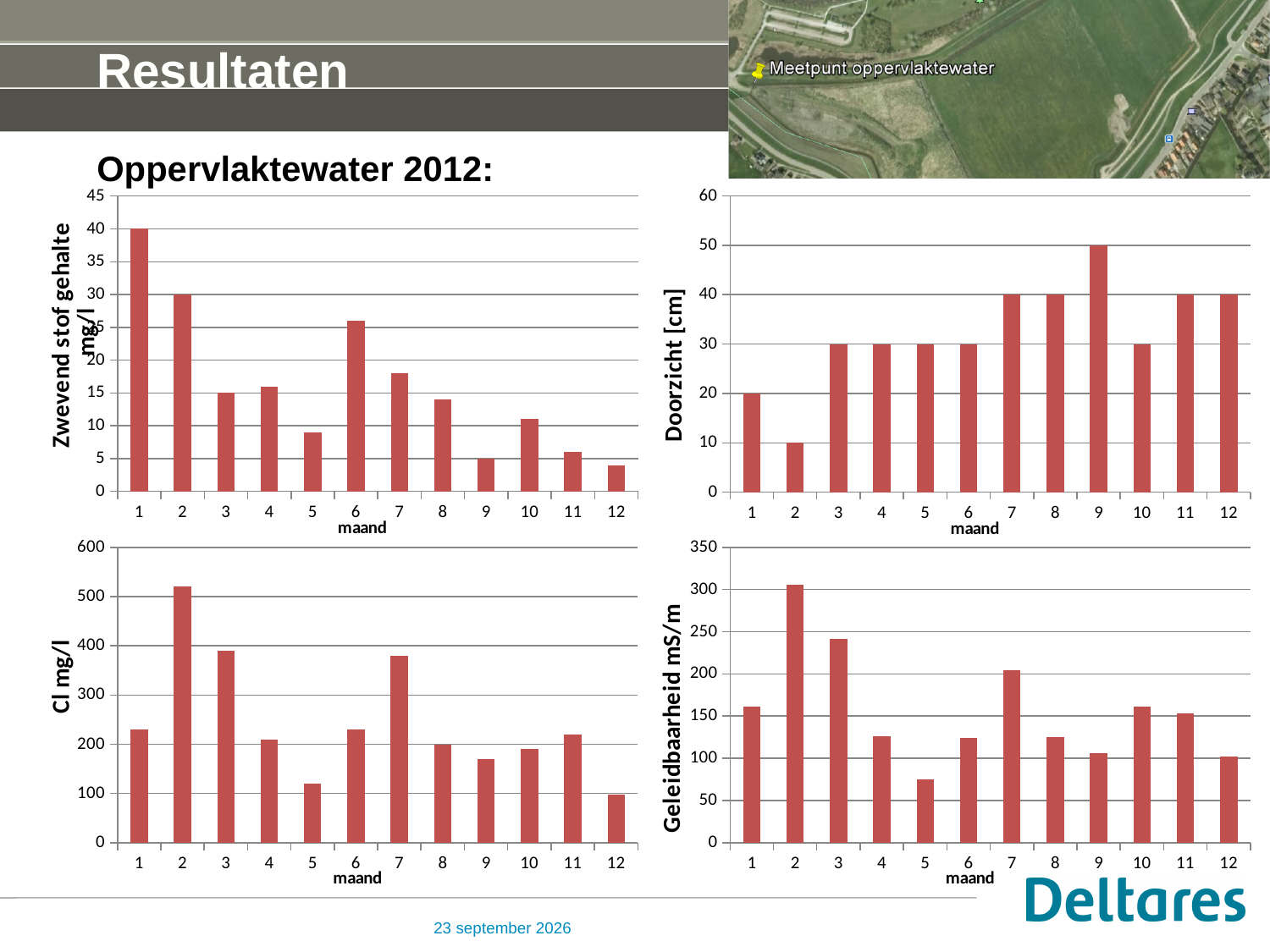
In the Geleidbaarheid mS/m chart, which month has the lowest value? 5 How many months are plotted in the Doorzicht [cm] chart? 12 In the Zwevend stof gehalte mg/l chart, what is the value for month 1? 40 In the Doorzicht [cm] chart, what is the difference between the values for month 9 and month 1? 30 In the Cl mg/l chart, is the value for month 3 greater or less than 300? greater In the Doorzicht [cm] chart, what is the value for month 9? 50 In the Geleidbaarheid mS/m chart, which is larger, the value for month 3 or the value for month 7? month 3 In the Zwevend stof gehalte mg/l chart, which month has the highest value? 1 In the Cl mg/l chart, which month has the highest value? 2 What type of chart is the Cl mg/l chart? bar chart In the Doorzicht [cm] chart, what is the value for month 2? 10